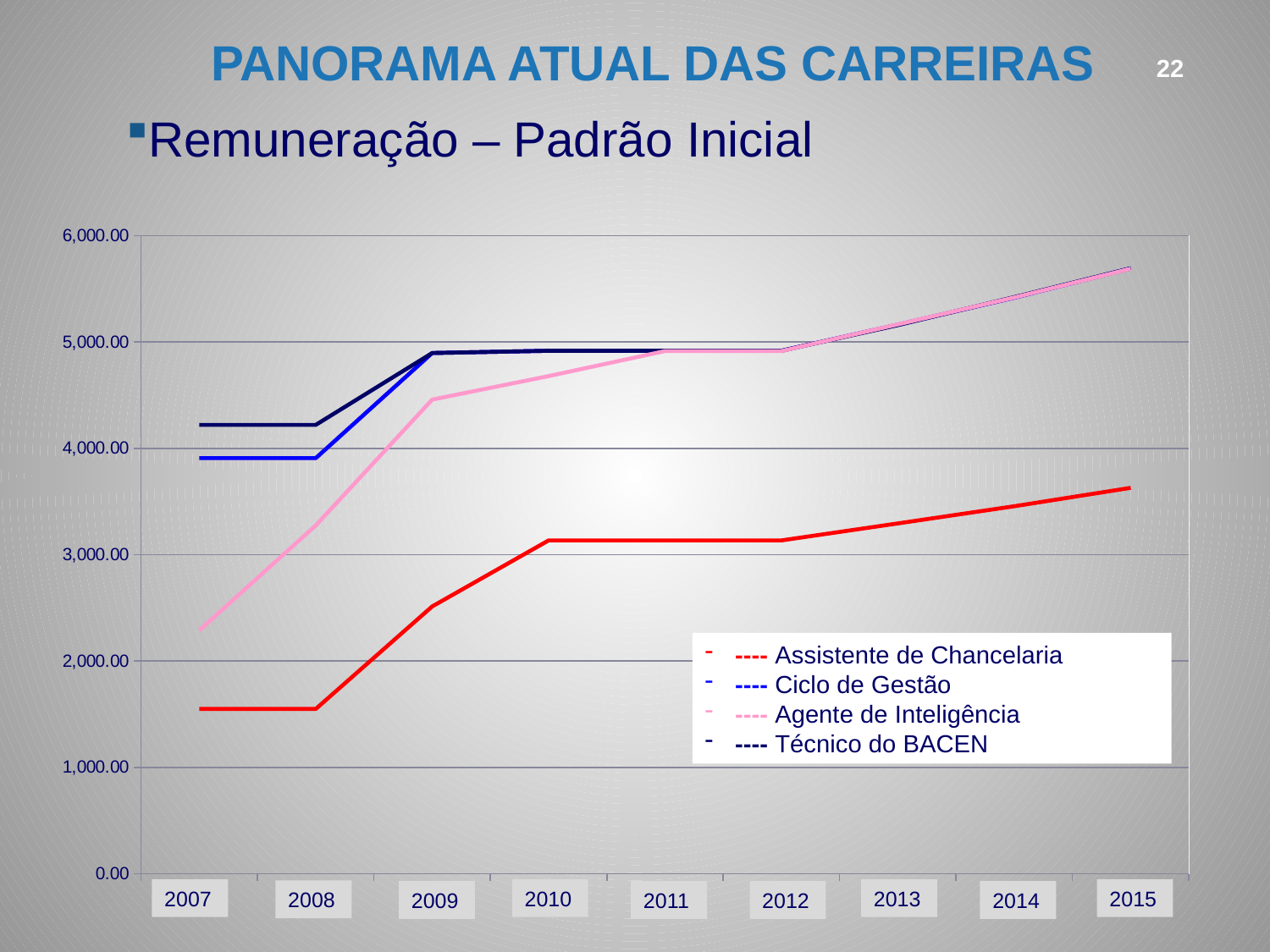
Which series has the lowest value in 2007? Assistente de Chancelaria Which series has the highest value in 2007? Técnico do BACEN Is the value for Agente de Inteligência in 2015 greater or less than 5,000.00? greater Is the value for Assistente de Chancelaria in 2007 greater or less than 2,000.00? less Is the value for Técnico do BACEN in 2007 greater or less than 4,000.00? greater What kind of chart is shown on the slide? line chart How many years are shown on the x axis? 9 How many series does the legend list? 4 In 2008, which is larger: Ciclo de Gestão or Agente de Inteligência? Ciclo de Gestão Does the value for Assistente de Chancelaria rise or fall from 2007 to 2015? rise Which series is drawn in pink? Agente de Inteligência